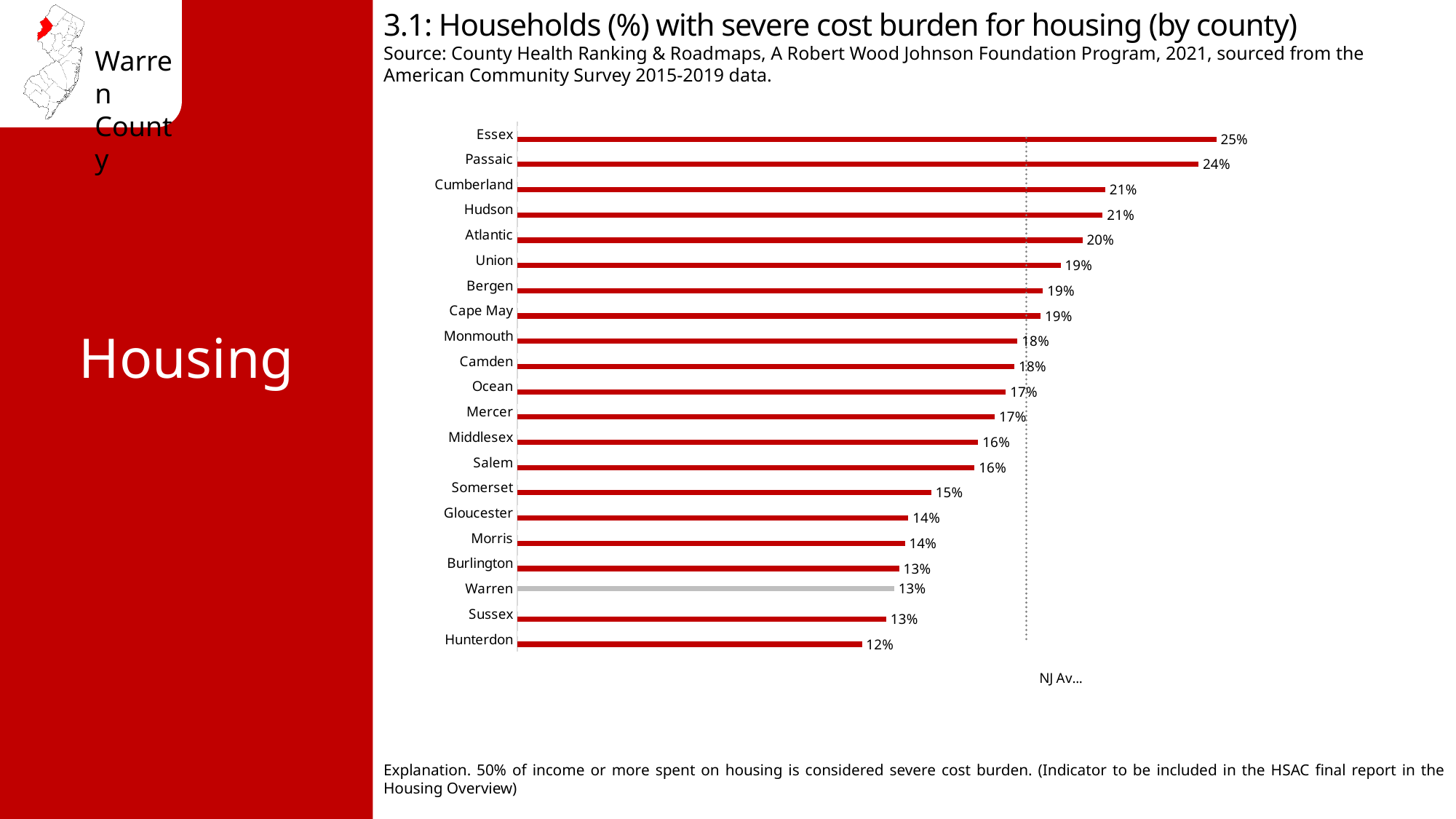
What is the difference between the values for Passaic and Hunterdon? 12 percentage points What is the difference between the values for Essex and Warren? 12 percentage points Which is larger, the value for Atlantic or the value for Somerset? Atlantic Which county has the lowest percentage of households with severe cost burden? Hunterdon What is the value for Atlantic County? 20% How many counties are shown in the chart? 21 What is the value for Warren County? 13% What is the value for Essex County? 25% Which county has the highest percentage of households with severe cost burden? Essex Do the values rise or fall going from the top bar (Essex) to the bottom bar (Hunterdon)? Fall What kind of chart is shown on the slide? Bar chart Which county's bar is coloured grey instead of red? Warren